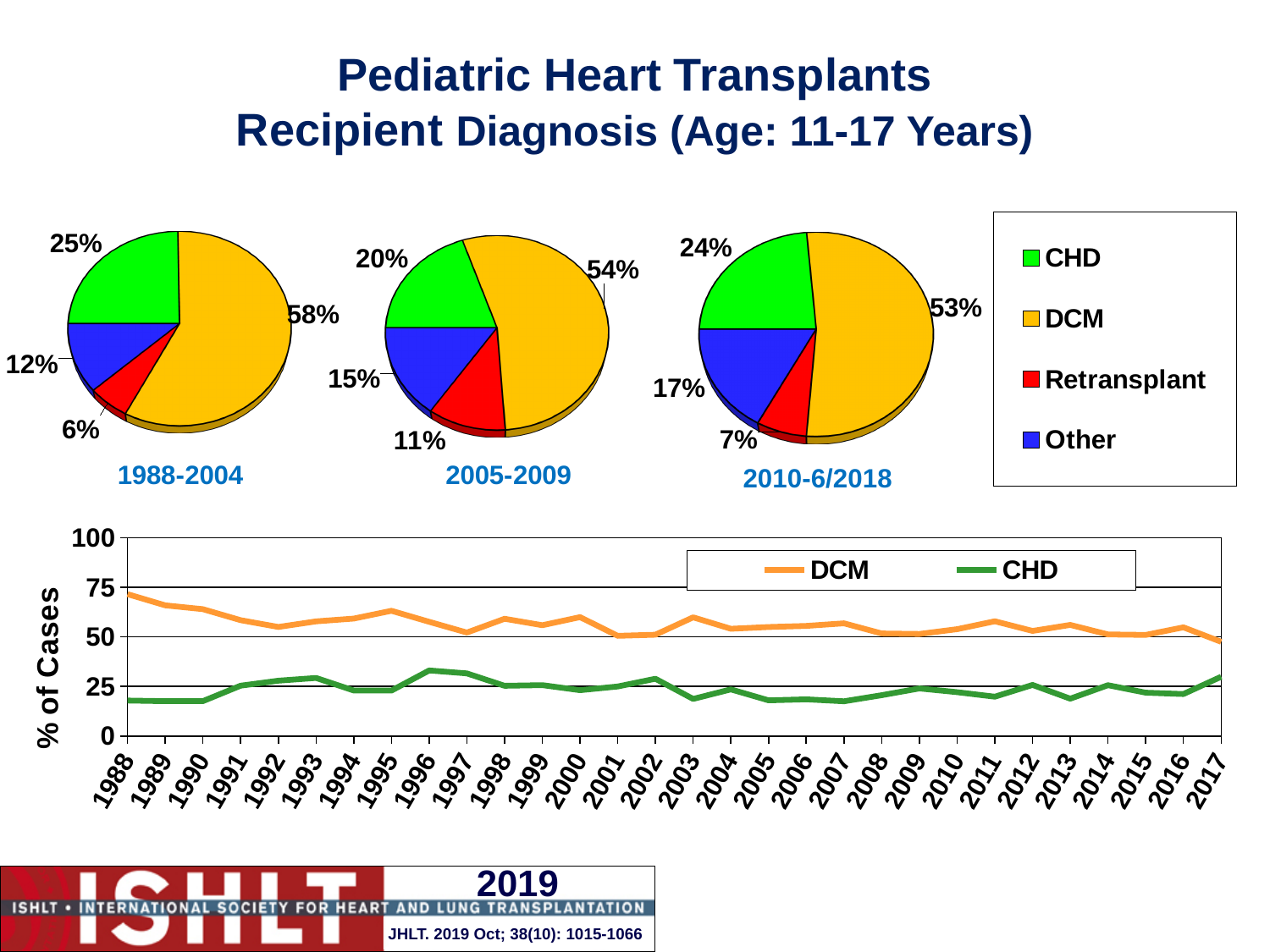
In the 2010-6/2018 pie chart, which diagnosis has the largest share? DCM Which is larger: the Other share in the 2005-2009 pie chart or the Other share in the 2010-6/2018 pie chart? 2010-6/2018 What is the difference between the CHD share in the 1988-2004 pie chart and the CHD share in the 2005-2009 pie chart? 5% In the bottom line chart, is the DCM value for 1988 greater or less than 50? greater How many series does the legend of the bottom line chart list? 2 In the 1988-2004 pie chart, what share of cases is DCM? 58% In the 2010-6/2018 pie chart, what share of cases is Other? 17% How many years are shown on the x axis of the bottom line chart? 30 In the bottom line chart, does the DCM series generally rise or fall from 1988 to 2017? fall In the 1988-2004 pie chart, which diagnosis has the smallest share? Retransplant In the 2005-2009 pie chart, what share of cases is Retransplant? 11% What kind of chart is the bottom chart showing % of Cases by year? line chart